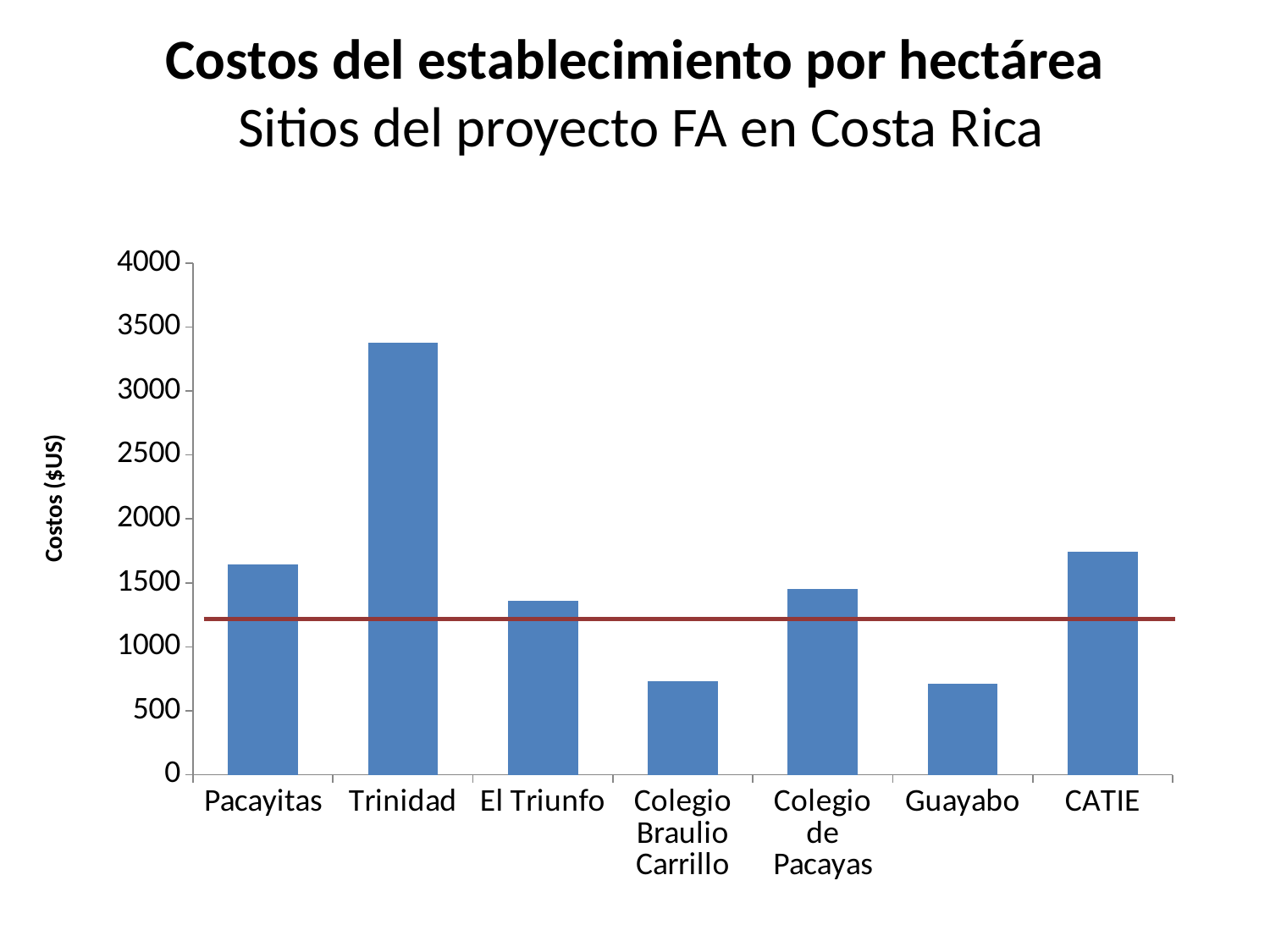
Which is larger, the value for Trinidad or the value for CATIE? Trinidad Is the value for Colegio Braulio Carrillo greater or less than 1000? less What kind of chart is shown on the slide? bar chart Which site has the highest establishment cost per hectare? Trinidad What is the label on the vertical axis of the chart? Costos ($US) Is the value for Colegio de Pacayas greater or less than 1000? greater Which is larger, the value for Pacayitas or the value for El Triunfo? Pacayitas Is the value for Guayabo greater or less than 1000? less How many sites (categories) are shown on the x axis of the chart? 7